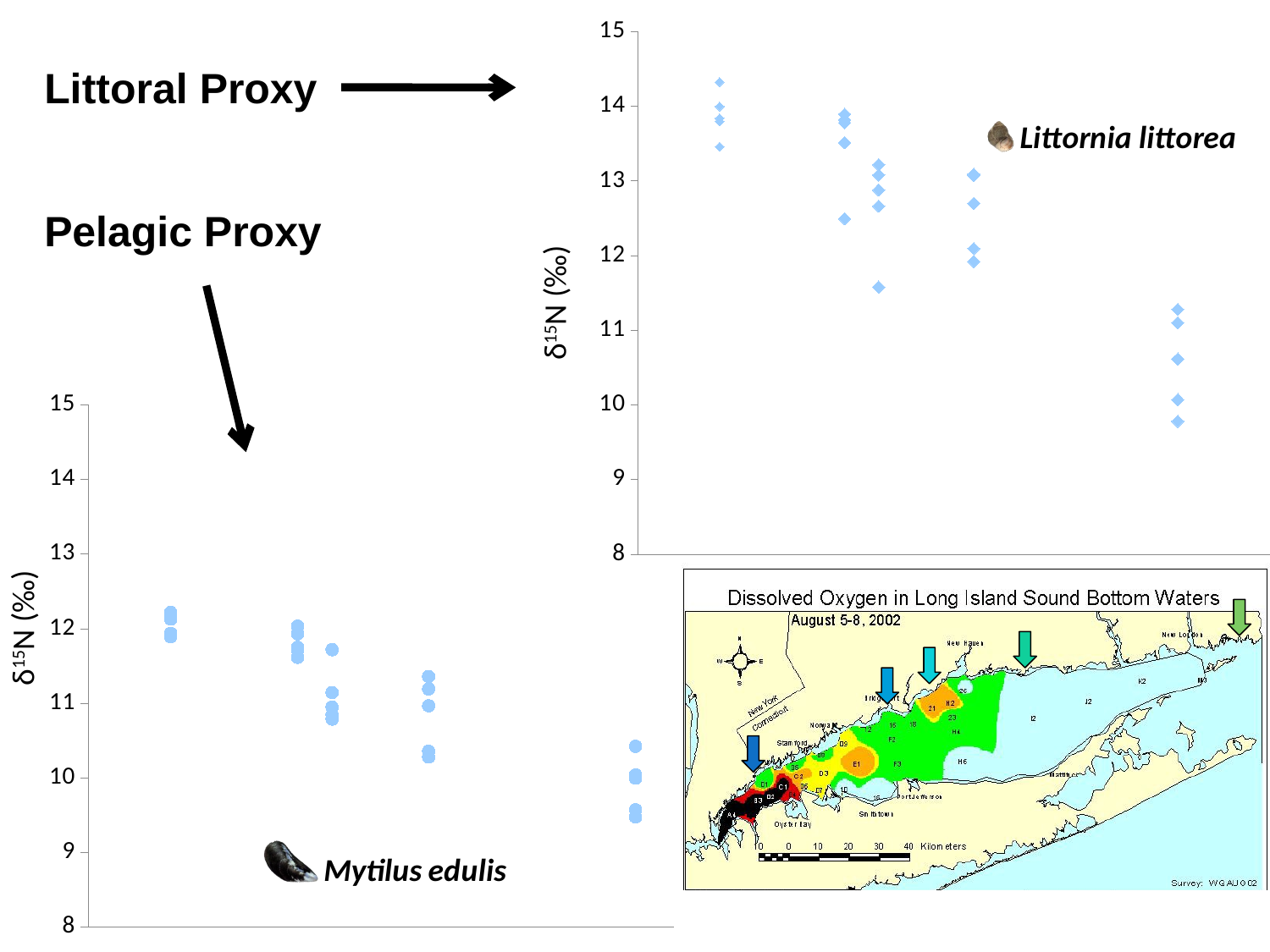
What is the y-axis label on the Littornia littorea chart? δ15N (‰) In the Littornia littorea chart, are the values of the leftmost cluster of points greater or less than 13? greater How many distinct clusters of points (sites) are plotted in the Littornia littorea chart? 5 What kind of chart is the Mytilus edulis chart in the bottom left? scatter chart Which species chart is labelled as the Pelagic Proxy? Mytilus edulis In the Littornia littorea chart, are the values of the rightmost cluster of points greater or less than 12? less What kind of chart is the Littornia littorea chart in the top right? scatter chart In the Littornia littorea chart, do the δ15N values generally rise or fall from left to right? fall In the Mytilus edulis chart, are the values of the rightmost cluster of points greater or less than 11? less In the Mytilus edulis chart, do the δ15N values generally rise or fall from left to right? fall How many distinct clusters of points (sites) are plotted in the Mytilus edulis chart? 5